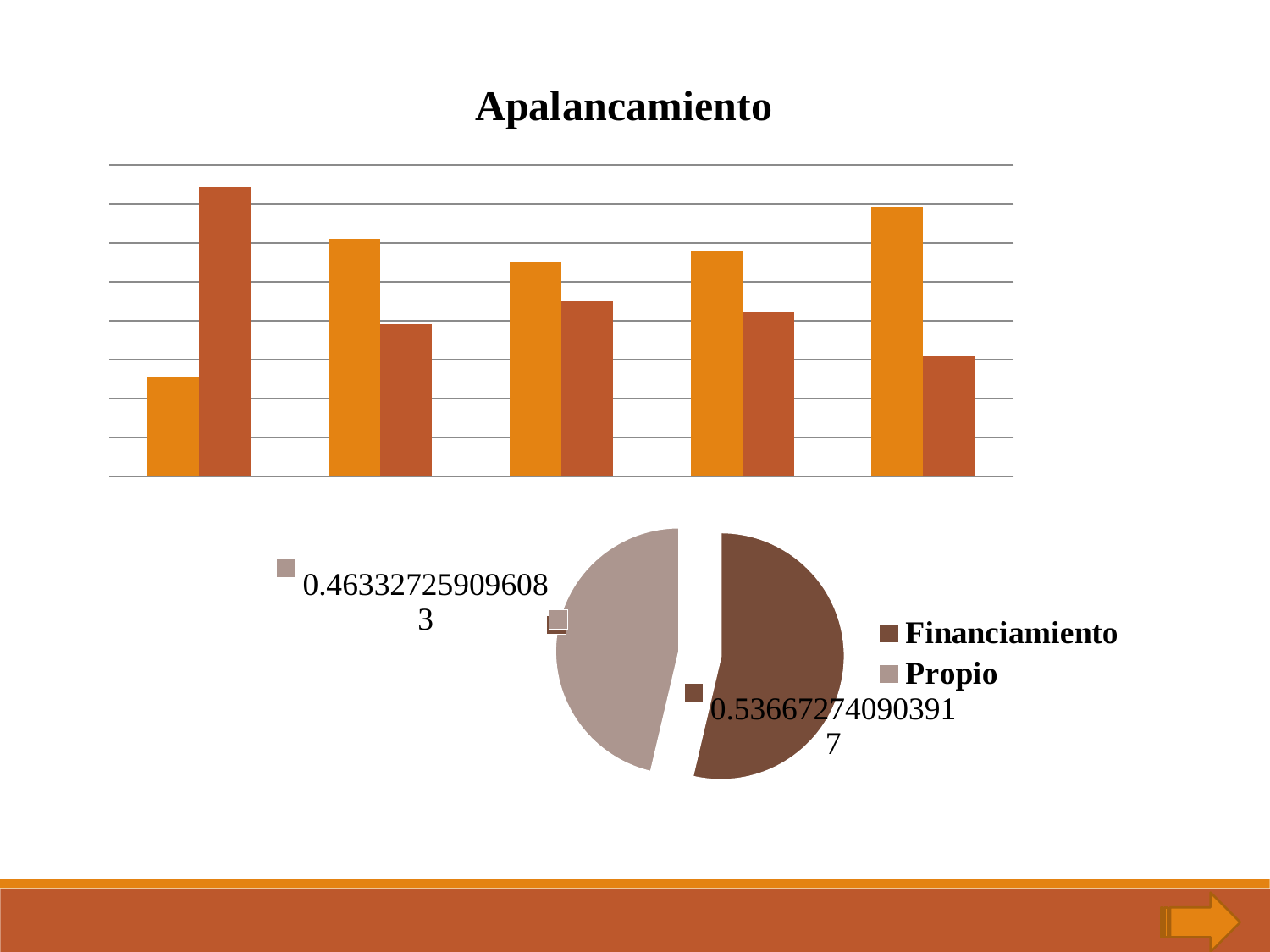
In the top bar chart titled "Apalancamiento", how many groups of bars are plotted along the x axis? 5 In the top bar chart titled "Apalancamiento", which group from the left contains the tallest bar? the first group In the top bar chart titled "Apalancamiento", how many bars are there in each group? 2 What kind of chart is the bottom chart on the slide? pie chart In the top bar chart titled "Apalancamiento", is the orange bar or the brown bar taller in the last group on the right? the orange bar What colour is the Propio slice in the bottom pie chart? light brown (tan) In the top bar chart titled "Apalancamiento", is the orange bar or the brown bar taller in the first group from the left? the brown bar In the bottom pie chart, what is the value shown for Financiamiento? 0.536672740903917 In the bottom pie chart, which slice is larger, Financiamiento or Propio? Financiamiento In the bottom pie chart, what is the value shown for Propio? 0.463327259096083 How many entries does the legend of the bottom pie chart list? 2 What kind of chart is the top chart titled "Apalancamiento"? bar chart